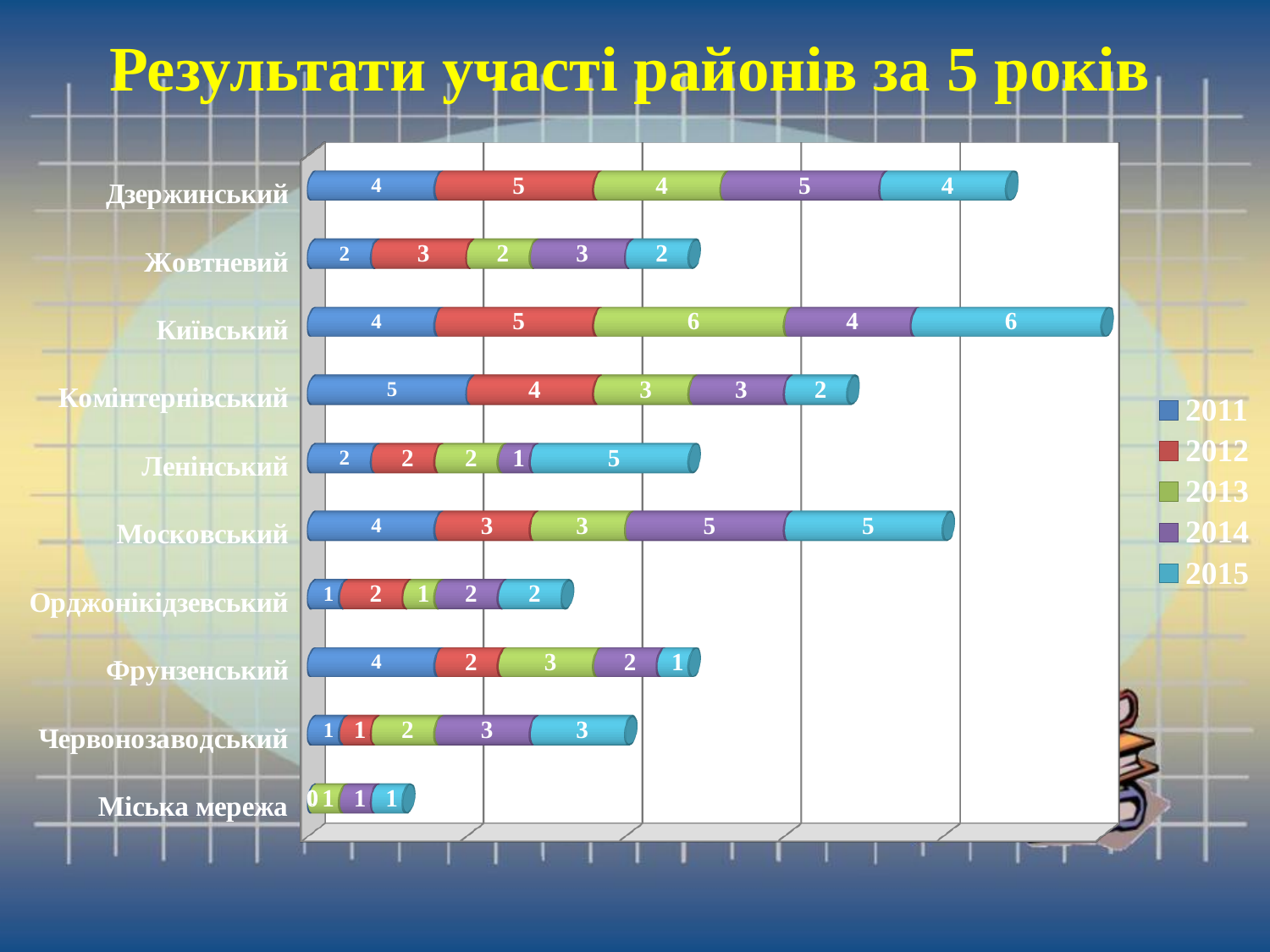
What is the 2013 value for Київський? 6 Which category has the shortest stacked bar overall? Міська мережа Which district has the longest stacked bar overall? Київський What is the 2011 value for Комінтернівський? 5 Which is larger: the 2011 value for Комінтернівський or the 2011 value for Московський? Комінтернівський How many categories (districts) are plotted on the chart? 10 How many series does the legend list? 5 What kind of chart is shown on the slide? bar chart What is the total of the stacked bar for Дзержинський? 22 What is the total of the stacked bar for Київський? 25 What is the 2015 value for Ленінський? 5 What is the difference between the 2015 value for Київський and the 2015 value for Жовтневий? 4